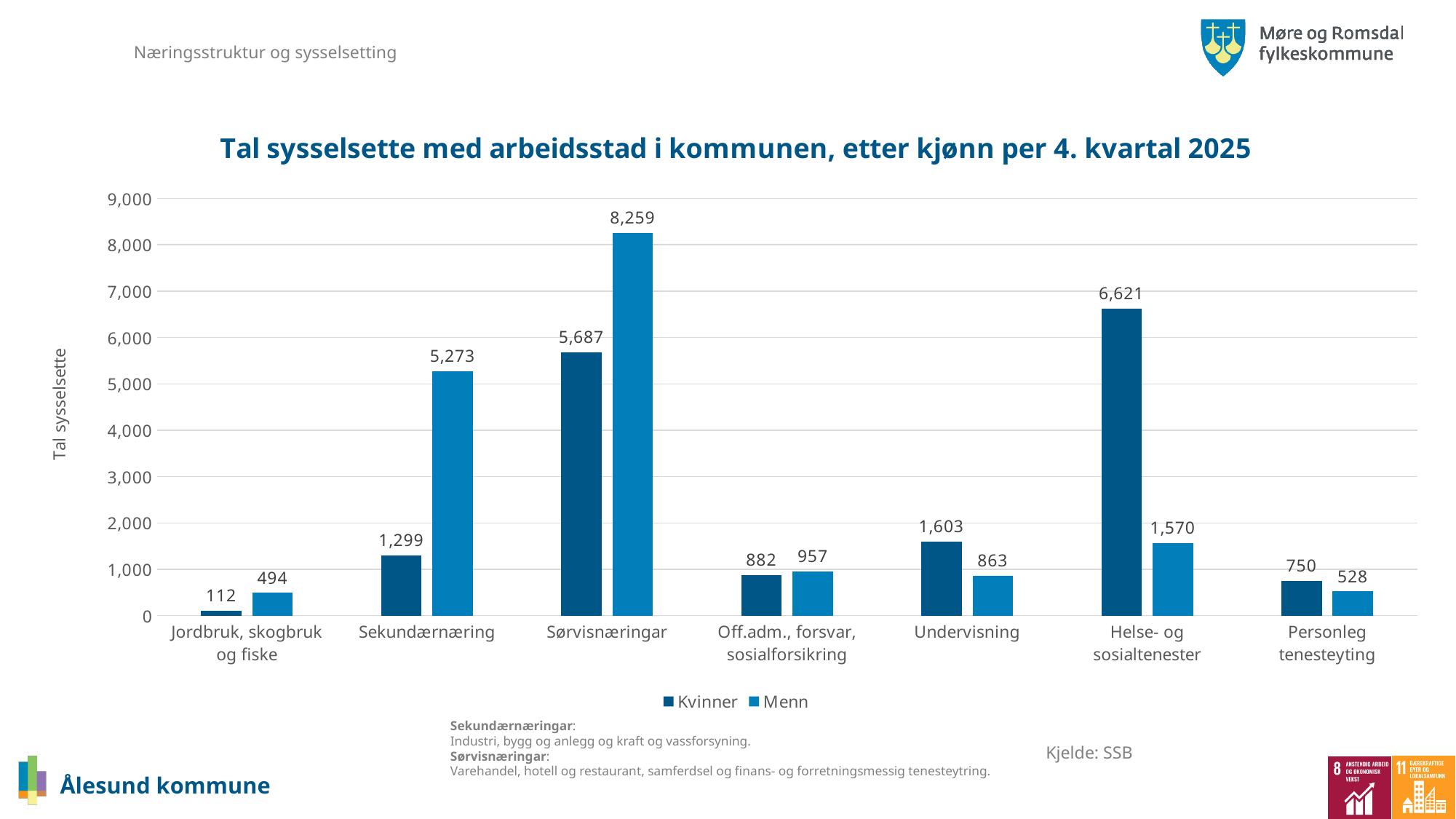
Is the Kvinner value for Helse- og sosialtenester greater or less than 6,000? greater What is the difference between the Menn and Kvinner values for Sørvisnæringar? 2,572 How many series does the legend list? 2 Which category has the lowest Kvinner value? Jordbruk, skogbruk og fiske What is the Kvinner value for Helse- og sosialtenester? 6,621 What is the source (Kjelde) given for the chart data? SSB How many employed women (Kvinner) are shown for Sørvisnæringar? 5,687 Which category has the highest Menn value? Sørvisnæringar What type of chart is shown on the slide? Bar chart How many industry categories are shown on the x axis? 7 For Undervisning, which series has the larger value, Kvinner or Menn? Kvinner What is the Menn value for Sekundærnæring? 5,273